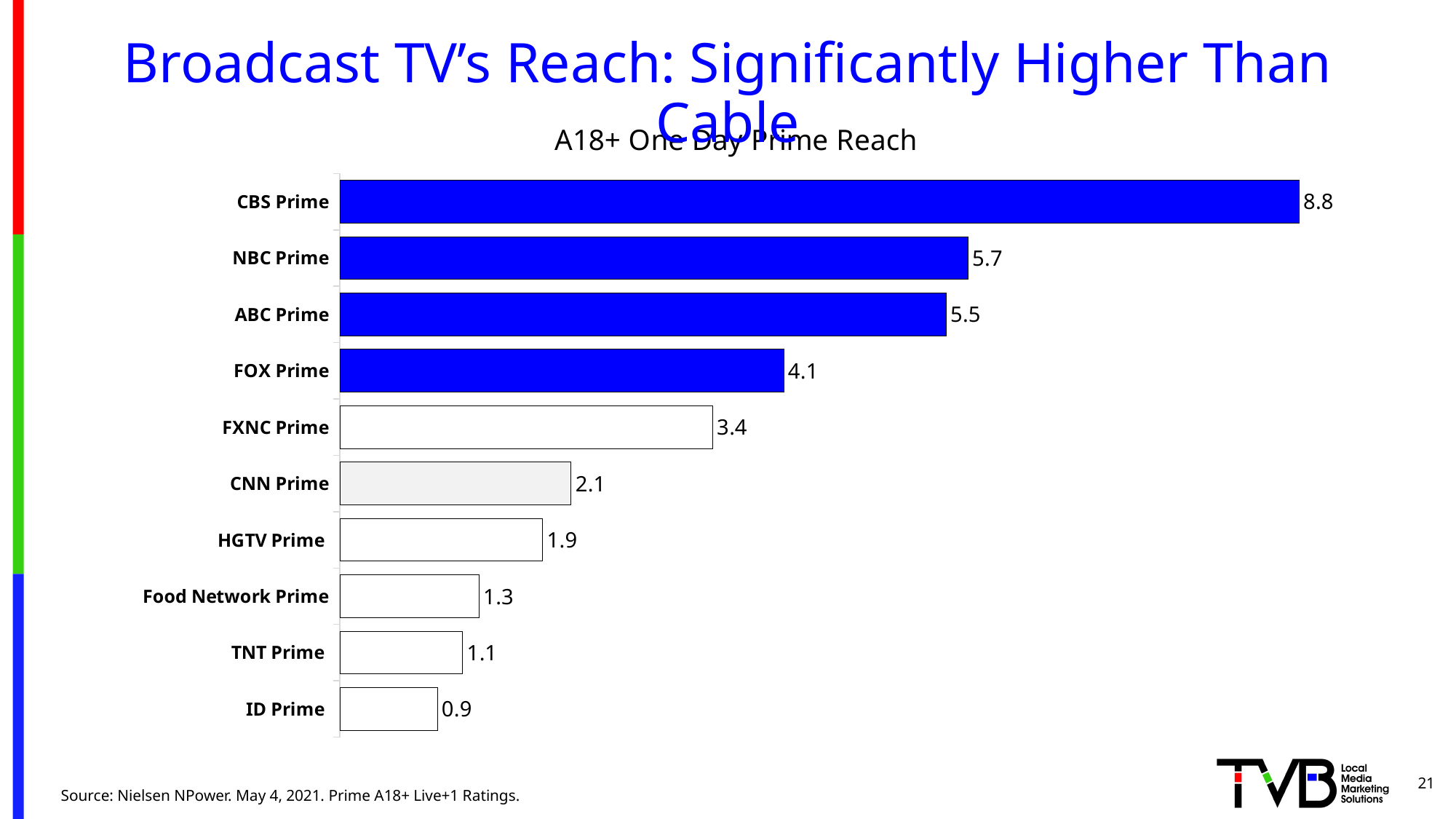
What is the difference between the values for CBS Prime and NBC Prime? 3.1 Which category has the lowest value in the chart? ID Prime What is the difference between the values for FOX Prime and FXNC Prime? 0.7 Which has a larger value, CNN Prime or HGTV Prime? CNN Prime Which has a larger value, NBC Prime or ABC Prime? NBC Prime What is the value shown for Food Network Prime? 1.3 What is the value shown for FXNC Prime? 3.4 What is the A18+ one day prime reach value for CBS Prime? 8.8 Which category has the highest value in the chart? CBS Prime What is the title of the chart? A18+ One Day Prime Reach What kind of chart is shown on the slide? bar chart How many categories are shown in the chart? 10